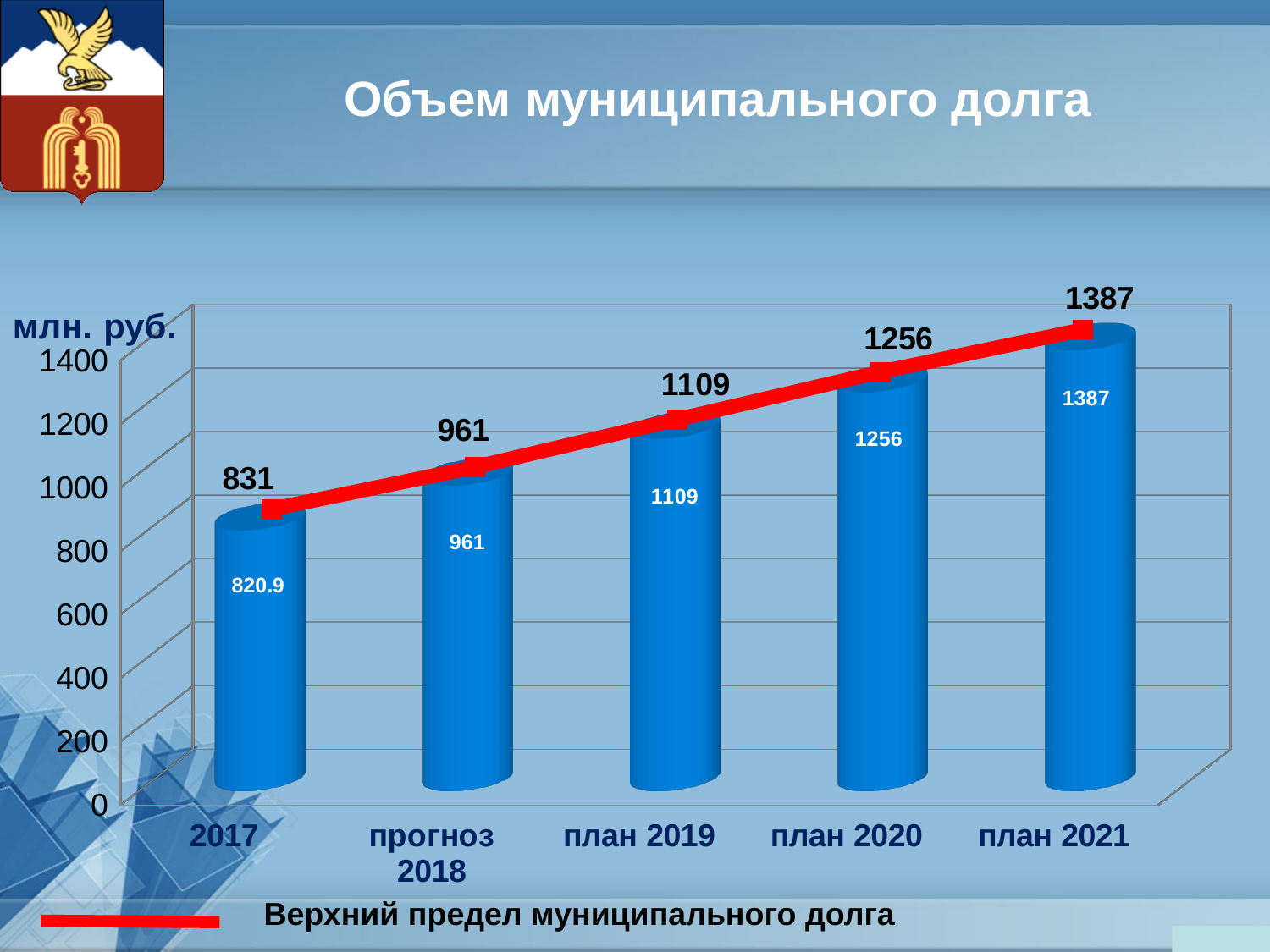
What is the value of the bar for 2017? 820.9 What is the title of the chart? Объем муниципального долга Is the bar value for прогноз 2018 greater or less than 1000? less Which is larger, the bar value for план 2019 or for план 2020? план 2020 Which category has the highest bar value? план 2021 What is the value of the bar for план 2021? 1387 What is the difference between the bar values for план 2020 and прогноз 2018? 295 Do the bar values rise or fall from 2017 to план 2021? rise What is the value of the bar for план 2019? 1109 How many categories are shown on the x axis? 5 Which category has the lowest bar value? 2017 What is the value of the red line (Верхний предел муниципального долга) for 2017? 831